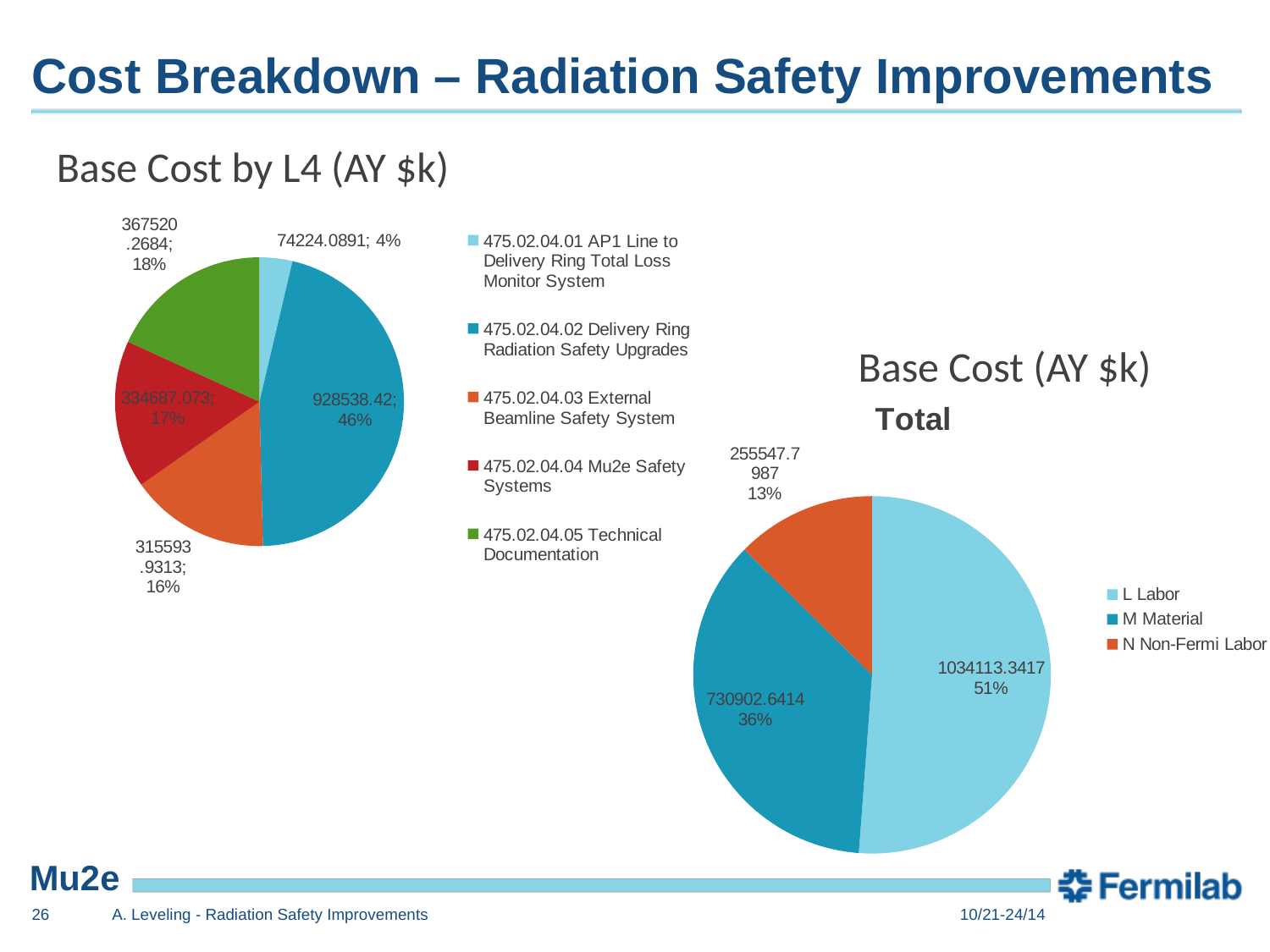
In the 'Base Cost by L4 (AY $k)' chart, what share of the pie is 475.02.04.01 AP1 Line to Delivery Ring Total Loss Monitor System? 4% In the 'Base Cost (AY $k)' Total chart, what share of the pie is L Labor? 51% In the 'Base Cost by L4 (AY $k)' chart, what share of the pie is 475.02.04.05 Technical Documentation? 18% In the 'Base Cost by L4 (AY $k)' chart, which category has the smallest slice? 475.02.04.01 AP1 Line to Delivery Ring Total Loss Monitor System In the 'Base Cost by L4 (AY $k)' chart, what colour is the slice for 475.02.04.04 Mu2e Safety Systems? red In the 'Base Cost by L4 (AY $k)' chart, what kind of chart is shown? pie chart In the 'Base Cost by L4 (AY $k)' chart, what is the value for 475.02.04.02 Delivery Ring Radiation Safety Upgrades? 928538.42 In the 'Base Cost (AY $k)' Total chart, which is larger, M Material or N Non-Fermi Labor? M Material In the 'Base Cost by L4 (AY $k)' chart, which category has the largest slice? 475.02.04.02 Delivery Ring Radiation Safety Upgrades In the 'Base Cost (AY $k)' Total chart, how many entries does the legend list? 3 In the 'Base Cost (AY $k)' Total chart, what is the value for M Material? 730902.6414 In the 'Base Cost by L4 (AY $k)' chart, how many slices does the pie have? 5